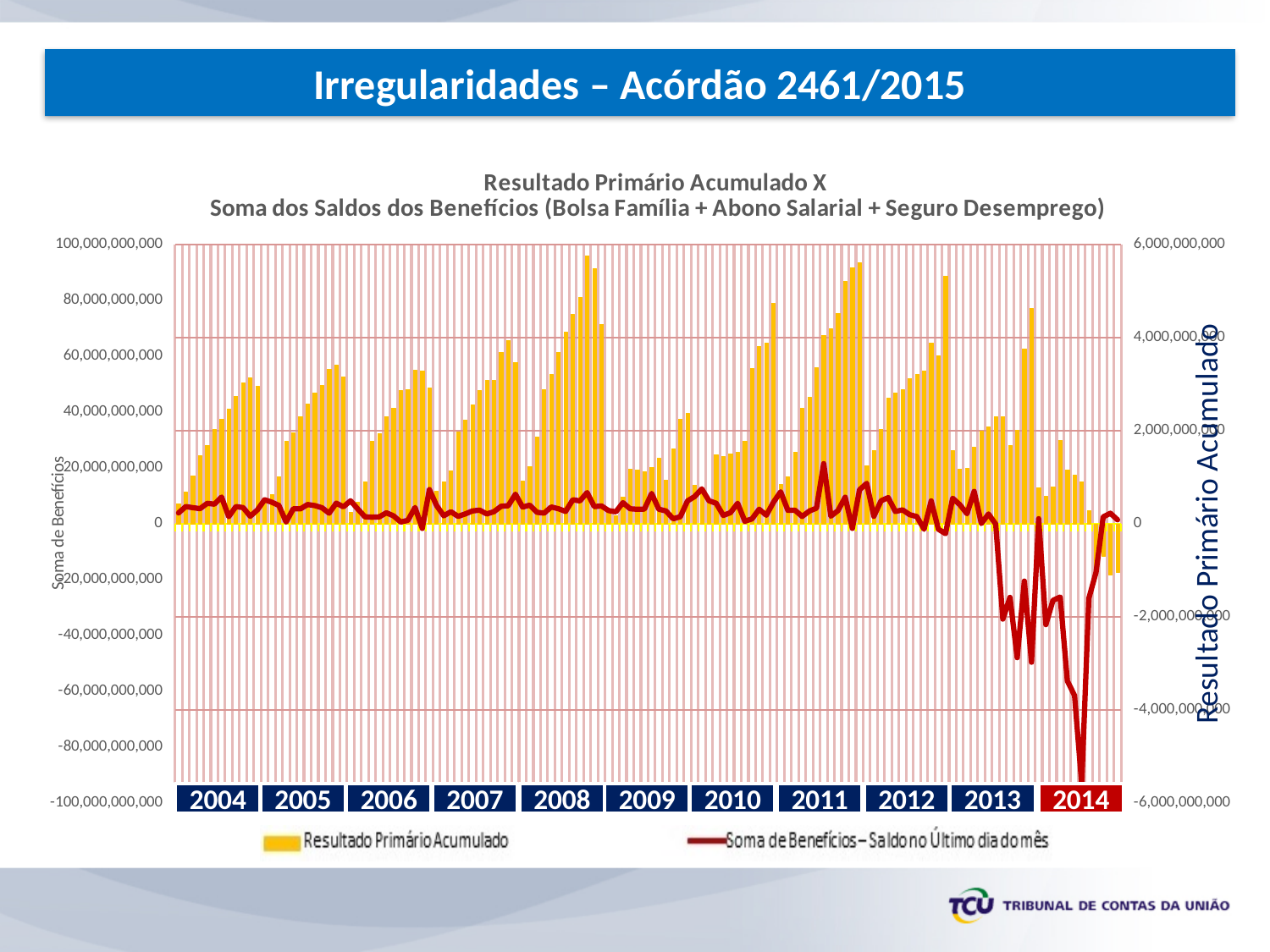
Is the tallest Resultado Primário Acumulado bar in 2008 greater or less than 80,000,000,000 on the left axis? greater What is the highest value shown on the left vertical axis? 100,000,000,000 Which series is drawn as a red line according to the legend? Soma de Benefícios – Saldo no Último dia do mês What is the lowest value shown on the right vertical axis? -6,000,000,000 Is the lowest point of the red line in 2013 greater or less than -2,000,000,000 on the right axis? less Is the lowest point of the red line in 2014 greater or less than -4,000,000,000 on the right axis? less Within each year from 2004 to 2012, do the Resultado Primário Acumulado bars generally rise or fall from the start of the year to the end? rise Which year is the first one labelled on the x axis? 2004 How many series does the legend list? 2 What kind of chart is shown on the slide? A combined bar and line chart How many years are labelled along the x axis? 11